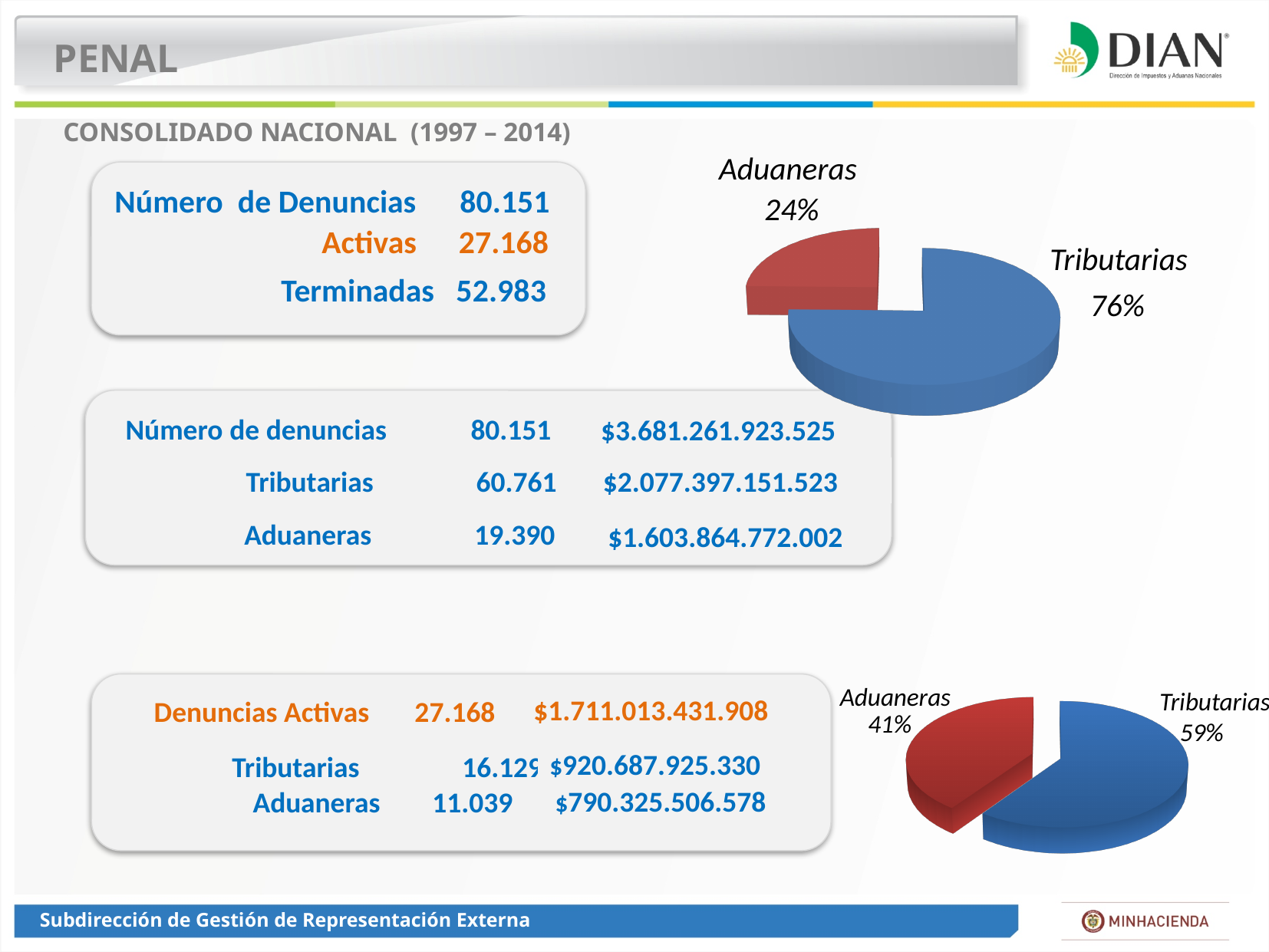
In the pie chart at the top right of the slide, what colour is the Aduaneras slice? Red In the pie chart at the bottom right of the slide, what share is labelled for Aduaneras? 41% In the pie chart at the bottom right of the slide, by how many percentage points does Tributarias exceed Aduaneras? 18 What kind of chart is shown at the bottom right of the slide? Pie chart Which is larger in the pie chart at the bottom right of the slide: the Tributarias slice or the Aduaneras slice? Tributarias In the pie chart at the top right of the slide, what share is labelled for Tributarias? 76% In the pie chart at the top right of the slide, which slice is the largest? Tributarias How many slices does the pie chart at the top right of the slide have? 2 In the pie chart at the top right of the slide, what share is labelled for Aduaneras? 24% In the pie chart at the bottom right of the slide, what share is labelled for Tributarias? 59% In the pie chart at the top right of the slide, by how many percentage points does Tributarias exceed Aduaneras? 52 In the pie chart at the bottom right of the slide, which slice is the smallest? Aduaneras